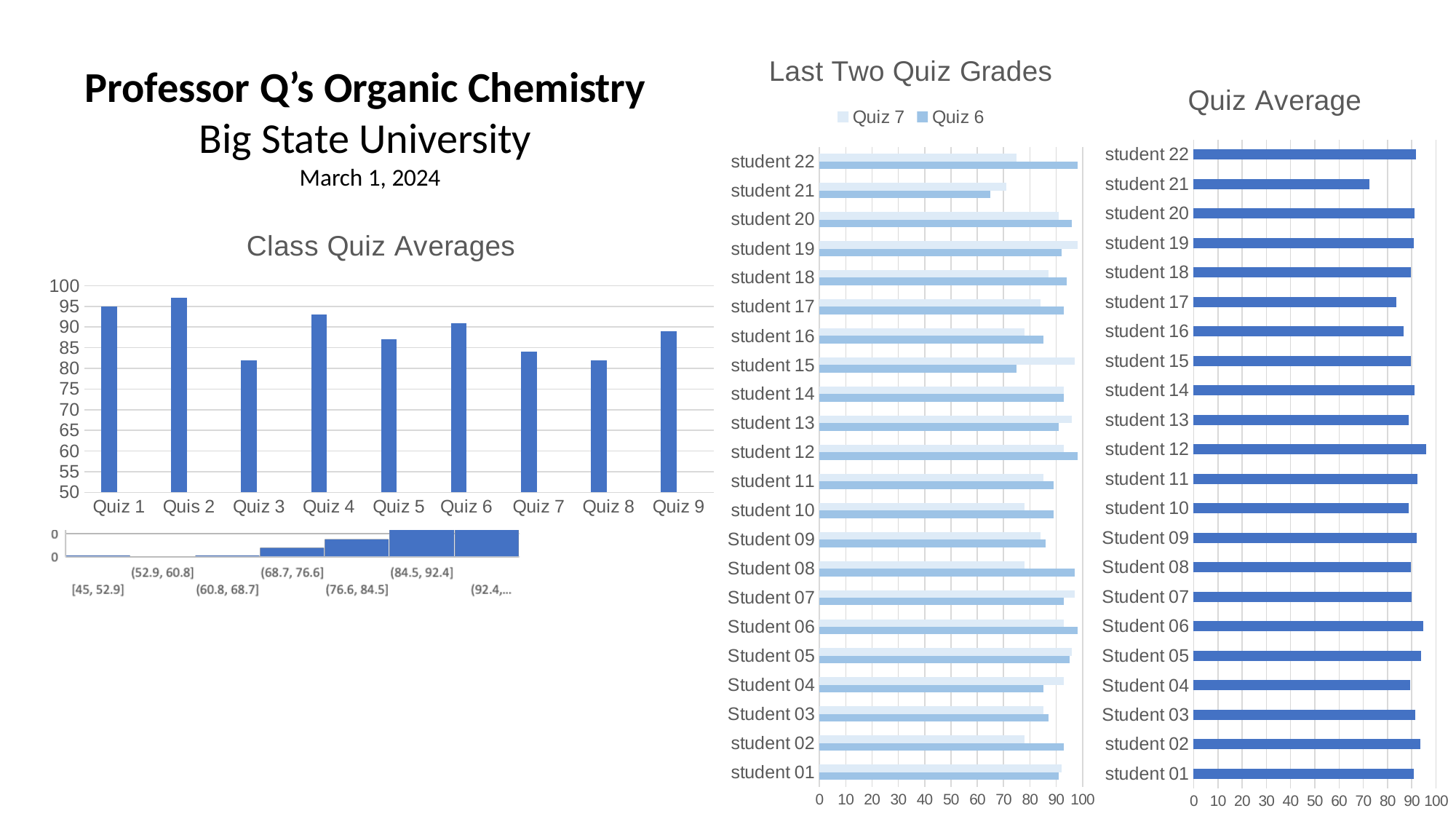
In the "Last Two Quiz Grades" chart, how many series does the legend list? 2 In the "Last Two Quiz Grades" chart, what are the two legend entries? Quiz 7 and Quiz 6 In the "Class Quiz Averages" chart, is the value for Quiz 4 greater or less than 90? greater In the "Quiz Average" chart, how many students are listed? 22 In the "Quiz Average" chart, which student has the lowest quiz average? student 21 In the "Last Two Quiz Grades" chart, is the Quiz 6 value for student 21 greater or less than 70? less In the "Class Quiz Averages" chart, how many quizzes are shown on the x axis? 9 In the "Class Quiz Averages" chart, which quiz has the highest average? Quis 2 What type of chart is the "Class Quiz Averages" chart? bar chart In the "Class Quiz Averages" chart, is the value for Quiz 3 greater or less than 85? less In the "Class Quiz Averages" chart, what is the value for Quiz 1? 95 In the "Last Two Quiz Grades" chart, for student 15, which is larger: the Quiz 7 grade or the Quiz 6 grade? Quiz 7